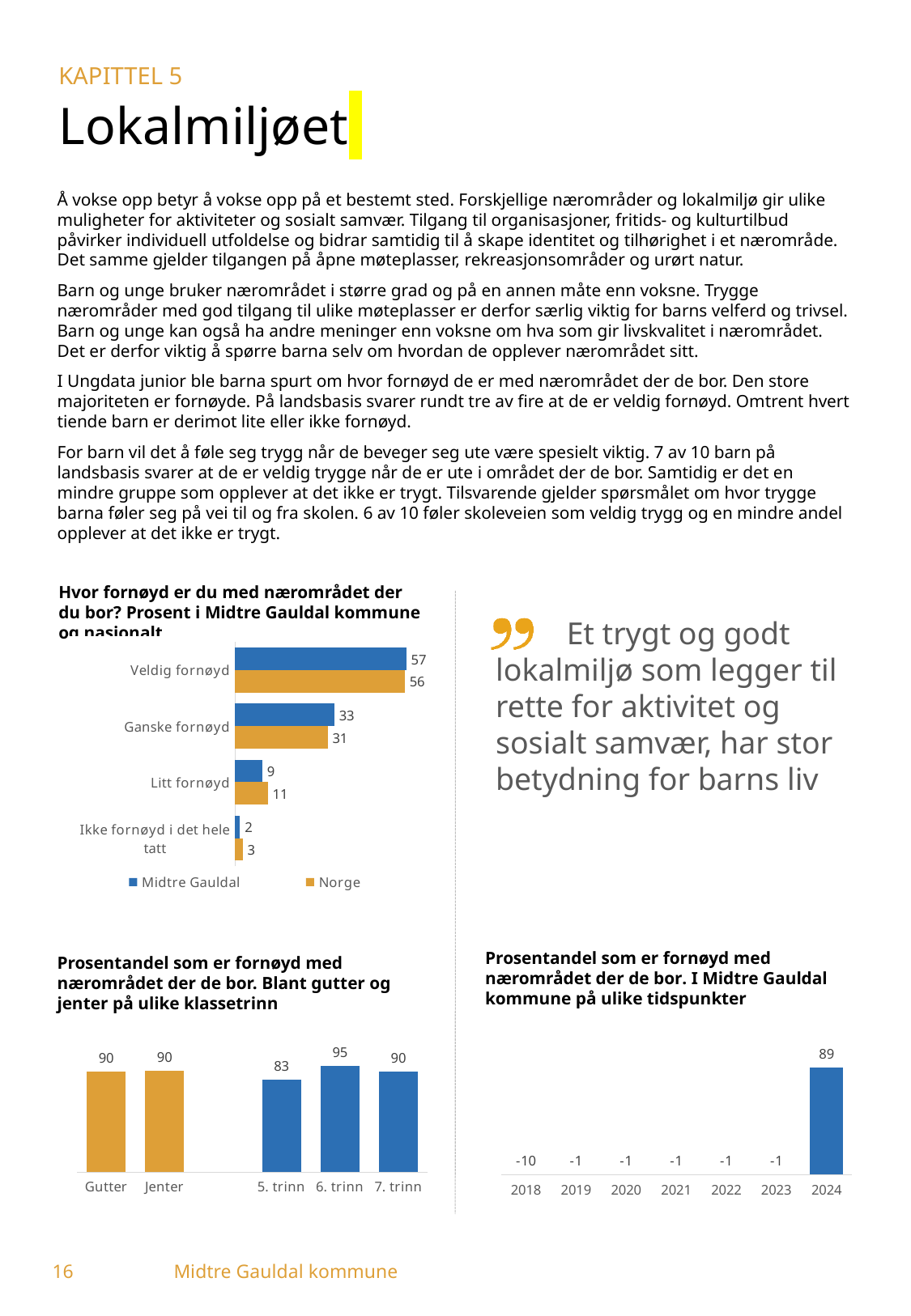
In the chart 'Hvor fornøyd er du med nærområdet der du bor?', which colour represents Norge? Orange In the chart 'Prosentandel som er fornøyd med nærområdet der de bor. Blant gutter og jenter på ulike klassetrinn', which category has the highest value? 6. trinn In the chart 'Hvor fornøyd er du med nærområdet der du bor?', what is the value for Norge for 'Litt fornøyd'? 11 In the chart 'Prosentandel som er fornøyd med nærområdet der de bor. I Midtre Gauldal kommune på ulike tidspunkter', what is the value for 2024? 89 In the chart 'Hvor fornøyd er du med nærområdet der du bor?', what is the value for Midtre Gauldal for 'Veldig fornøyd'? 57 In the chart 'Prosentandel som er fornøyd med nærområdet der de bor. Blant gutter og jenter på ulike klassetrinn', is the value for Gutter or Jenter larger, or are they equal? Equal In the chart 'Prosentandel som er fornøyd med nærområdet der de bor. Blant gutter og jenter på ulike klassetrinn', how many categories are shown? 5 What kind of chart is 'Hvor fornøyd er du med nærområdet der du bor?'? Bar chart In the chart 'Hvor fornøyd er du med nærområdet der du bor?', which category has the lowest value for Midtre Gauldal? Ikke fornøyd i det hele tatt In the chart 'Hvor fornøyd er du med nærområdet der du bor?', what is the difference between Midtre Gauldal and Norge for 'Ganske fornøyd'? 2 In the chart 'Hvor fornøyd er du med nærområdet der du bor?', how many series does the legend list? 2 In the chart 'Prosentandel som er fornøyd med nærområdet der de bor. Blant gutter og jenter på ulike klassetrinn', what is the value for 5. trinn? 83